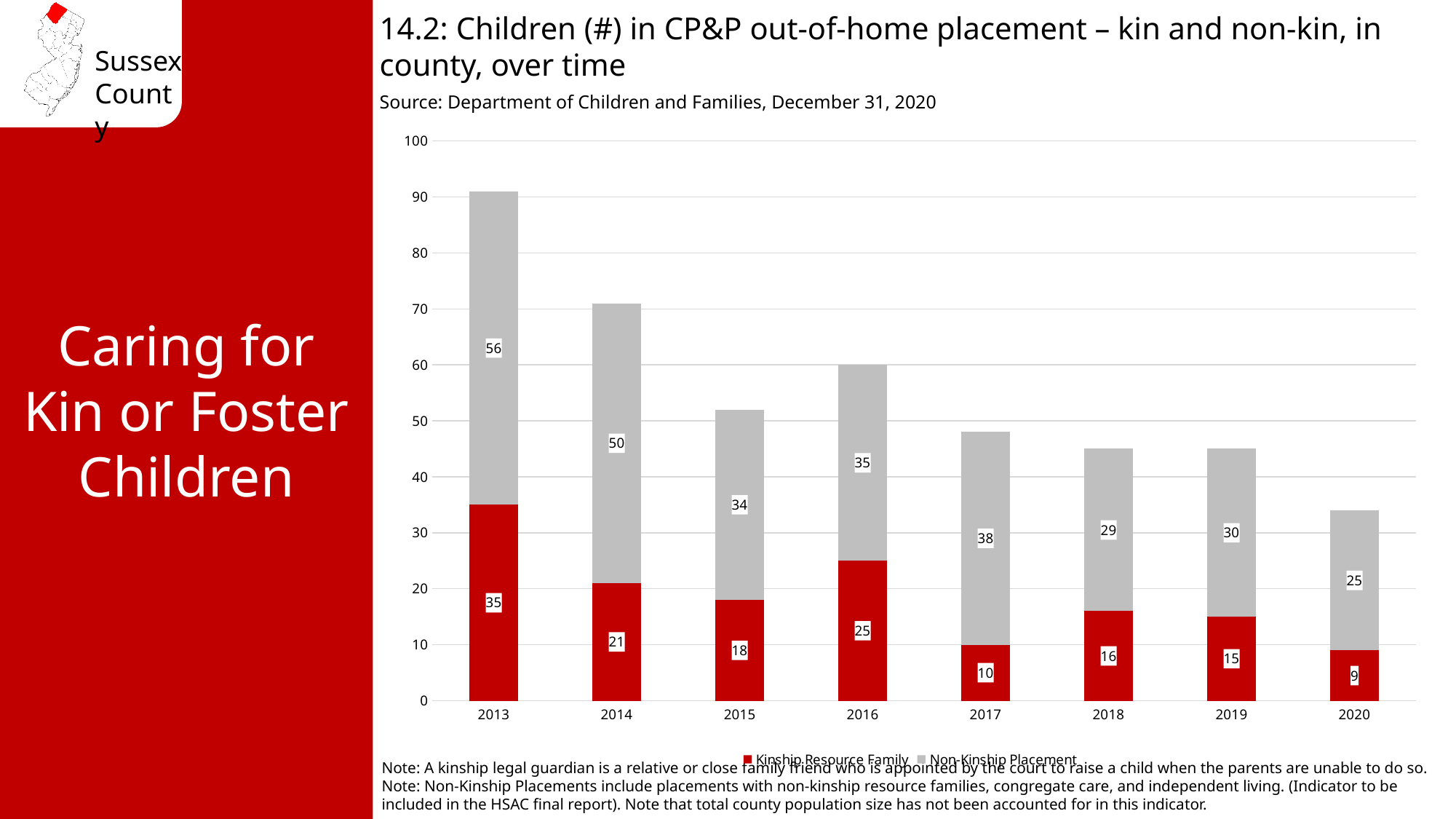
What is the difference between the Non-Kinship Placement value and the Kinship Resource Family value in 2016? 10 How many series does the legend list? 2 What is the total number of children in out-of-home placement in 2014 (both series combined)? 71 Which year has the lowest Kinship Resource Family value? 2020 What kind of chart is shown on the slide? Stacked bar chart What is the Non-Kinship Placement value for 2017? 38 What is the Kinship Resource Family value for 2020? 9 What is the Kinship Resource Family value for 2013? 35 Which is larger in 2018: the Kinship Resource Family value or the Non-Kinship Placement value? Non-Kinship Placement How many years are shown on the x axis? 8 Which year has the highest Non-Kinship Placement value? 2013 Does the Non-Kinship Placement value generally rise or fall from 2013 to 2020? Fall